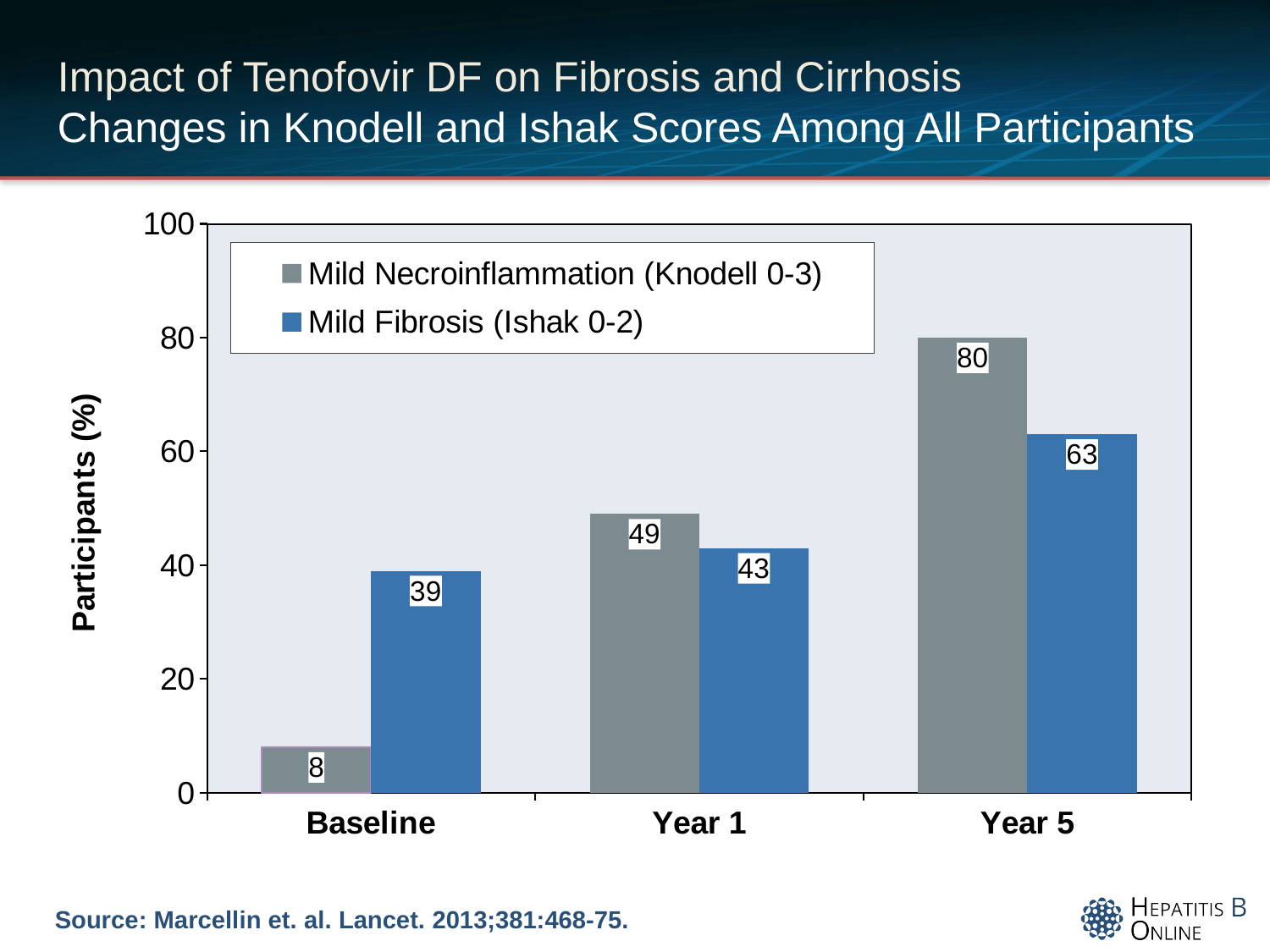
What is the difference between the mild necroinflammation values at Year 5 and baseline? 72 At which time point is the mild fibrosis (Ishak 0-2) value lowest? Baseline What kind of chart is shown on the slide? Bar chart At which time point is the mild necroinflammation (Knodell 0-3) value highest? Year 5 Is the value for mild fibrosis (Ishak 0-2) at Year 5 greater or less than 60? greater How many series does the legend list? 2 What percentage of participants had mild fibrosis (Ishak 0-2) at Year 5? 63 What is the value for mild fibrosis (Ishak 0-2) at Year 1? 43 How many time points are shown on the x axis? 3 What percentage of participants had mild necroinflammation (Knodell 0-3) at baseline? 8 Does the mild fibrosis (Ishak 0-2) value rise or fall from baseline to Year 5? Rise At Year 1, which is larger: mild necroinflammation (Knodell 0-3) or mild fibrosis (Ishak 0-2)? Mild Necroinflammation (Knodell 0-3)